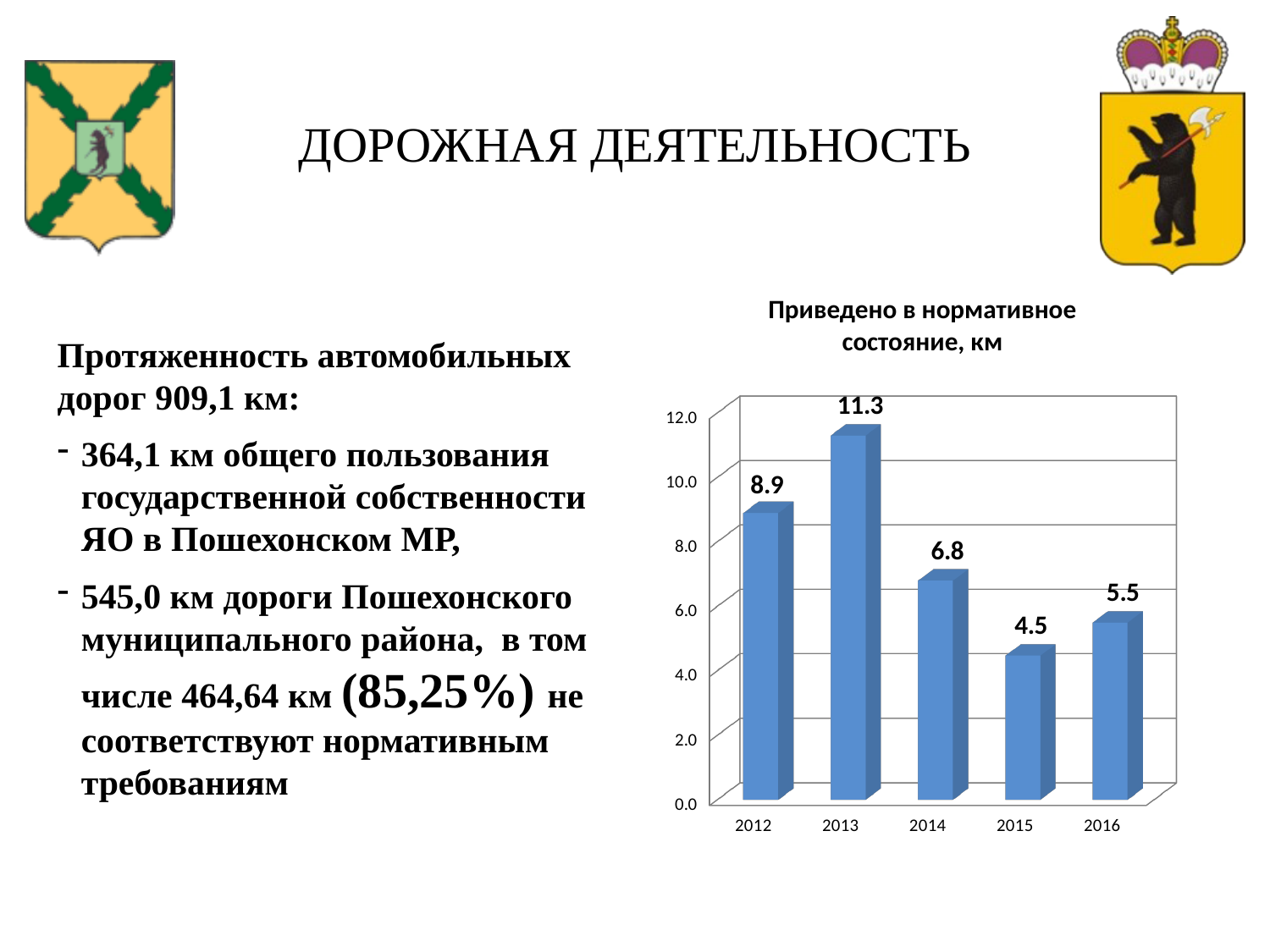
Which year has the lowest value? 2015 What is the value for 2012? 8.9 What is the value for 2013? 11.3 What is the value for 2016? 5.5 Which is larger, the value for 2014 or the value for 2016? 2014 What kind of chart is shown on the slide? bar chart Is the value for 2015 greater or less than 6.0? less What is the title of the chart? Приведено в нормативное состояние, км How many years are shown on the chart? 5 Which year has the highest value? 2013 What is the difference between the values for 2013 and 2014? 4.5 What is the difference between the values for 2012 and 2015? 4.4